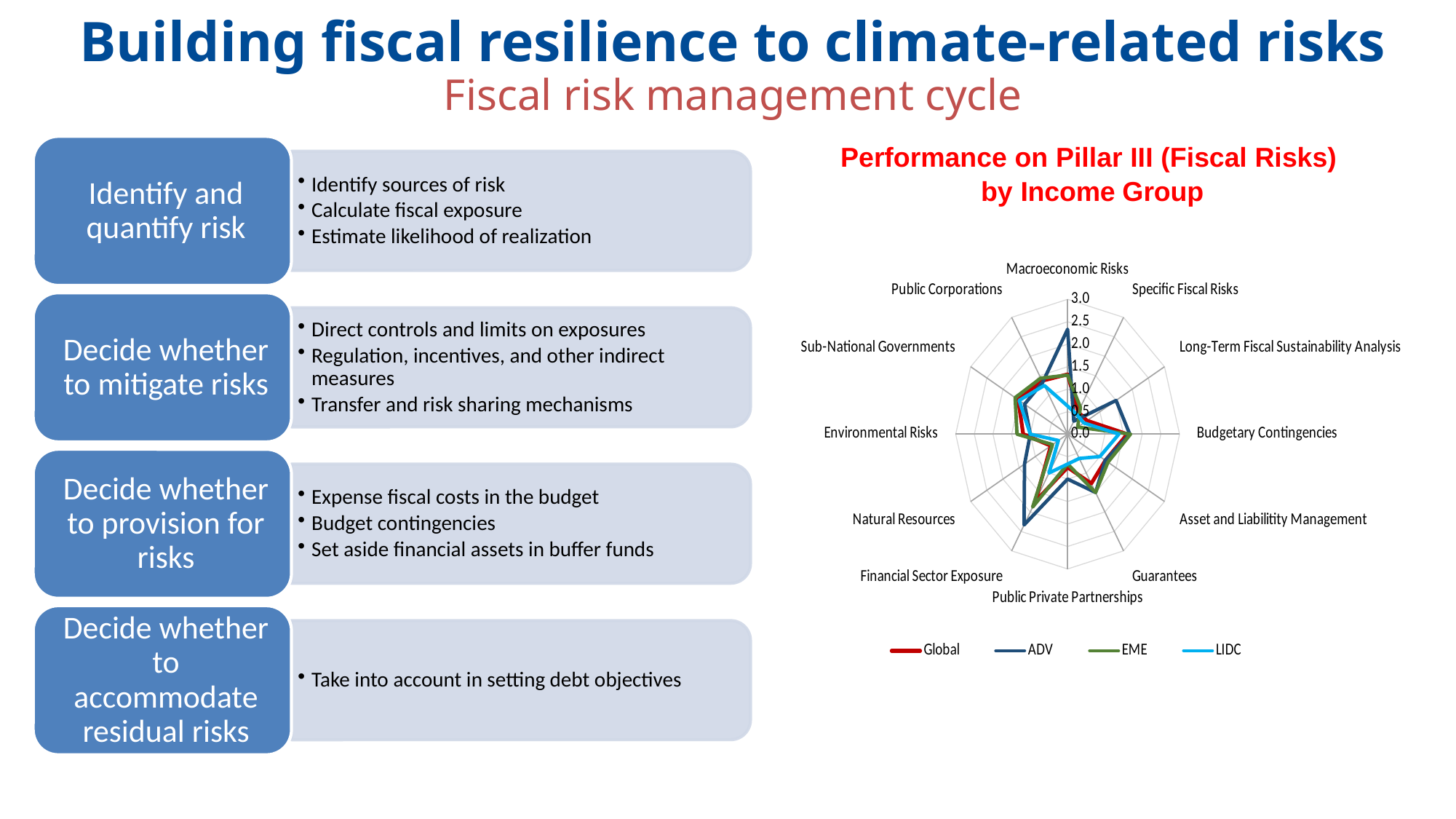
For Macroeconomic Risks, which series has the larger value, ADV or LIDC? ADV How many categories (axes) does the radar chart have? 12 Is the LIDC value for Macroeconomic Risks greater or less than 1.5? less Is the ADV value for Financial Sector Exposure greater or less than 1.5? greater Which series has the lowest value for Macroeconomic Risks? LIDC What kind of chart is shown on the slide? Radar chart What is the title of the chart on the slide? Performance on Pillar III (Fiscal Risks) by Income Group Which series has the highest value for Financial Sector Exposure? ADV Is the ADV value for Macroeconomic Risks greater or less than 1.5? greater What is the maximum value shown on the chart's radial axis? 3.0 How many series does the chart's legend list? 4 Which series has the highest value for Macroeconomic Risks? ADV